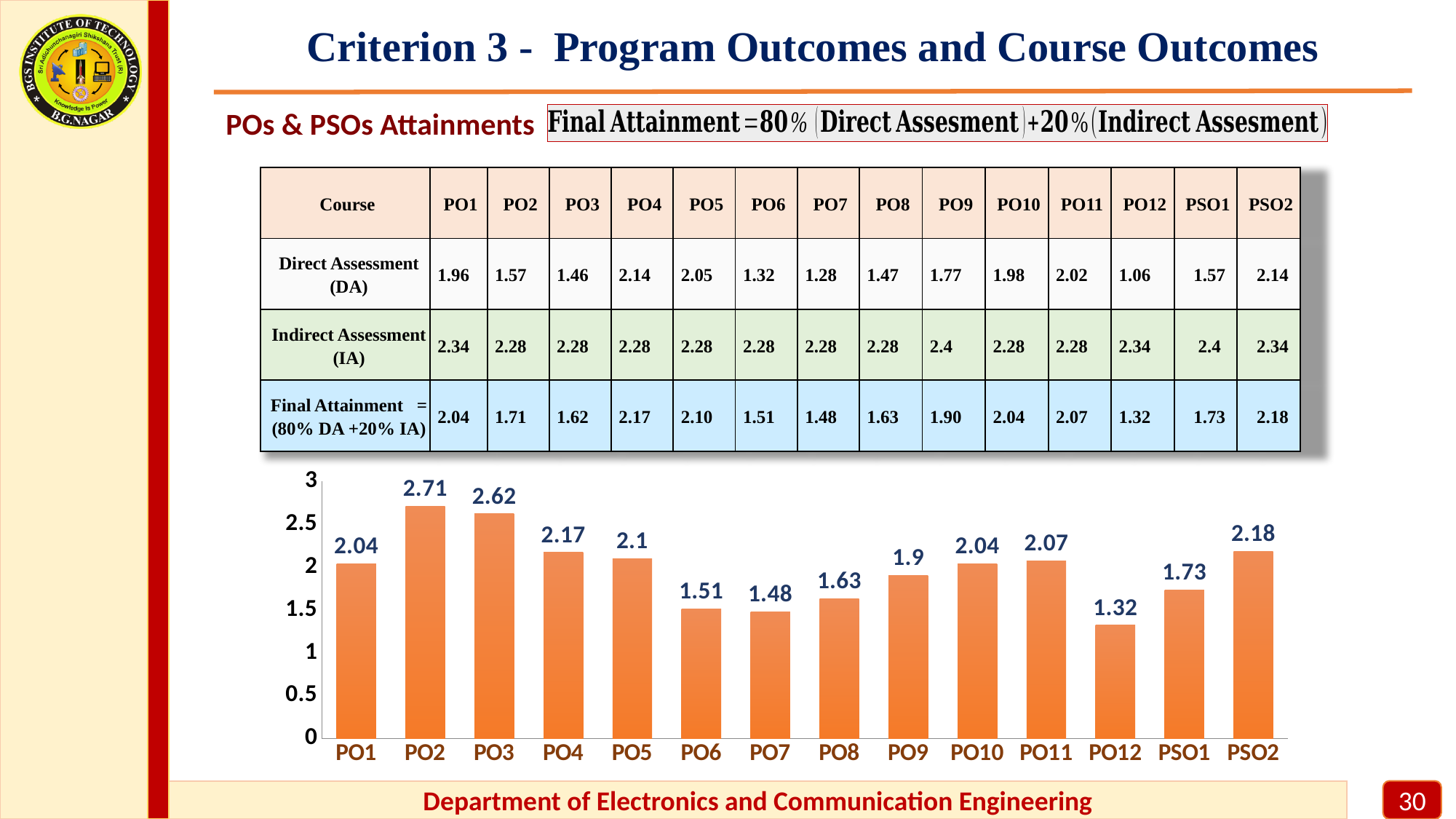
Which category has the highest bar in the chart? PO2 Is the value for PO6 in the chart greater or less than 2? less What is the difference between the values for PSO2 and PSO1 in the chart? 0.45 What is the difference between the values for PO2 and PO12 in the chart? 1.39 What is the value shown for PO7 in the bar chart? 1.48 What kind of chart is shown on the slide? bar chart Which category has the lowest bar in the chart? PO12 How many categories are plotted on the x axis of the chart? 14 What is the value shown for PSO1 in the bar chart? 1.73 Which has a larger value in the chart, PO4 or PO5? PO4 What is the value shown for PO2 in the bar chart? 2.71 From PO9 to PO11, do the values in the chart rise or fall? rise